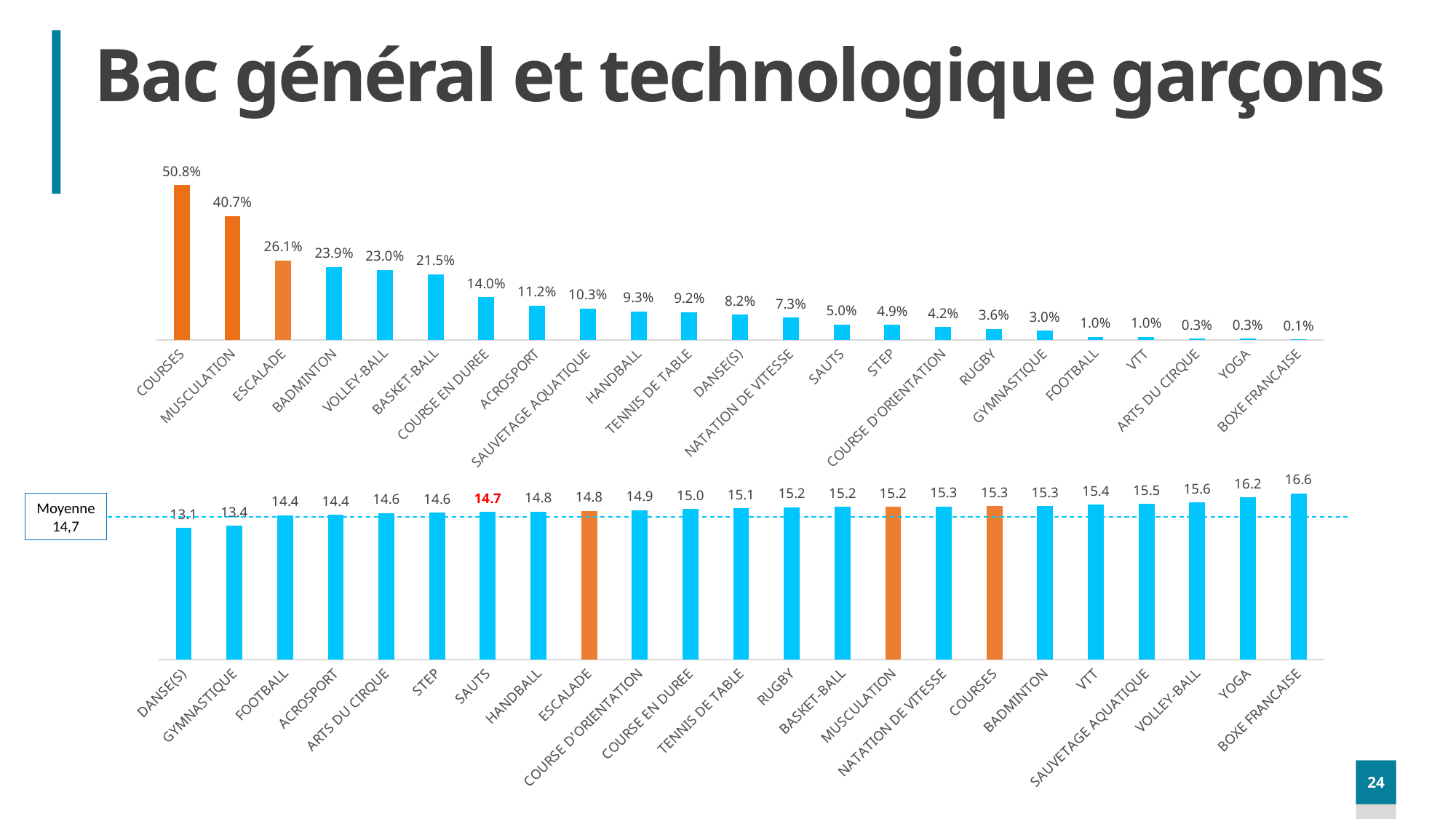
In the bottom chart, do the values rise or fall from left to right? rise In the bottom chart, which category has the lowest value? DANSE(S) In the top chart, what is the value for COURSES? 50.8% What type of chart is the bottom chart? bar chart In the bottom chart, what value is shown in the 'Moyenne' box next to the dashed line? 14,7 In the top chart, what is the difference between COURSES and MUSCULATION? 10.1% In the bottom chart, what is the value for BOXE FRANCAISE? 16.6 In the bottom chart, what is the difference between YOGA and GYMNASTIQUE? 2.8 In the top chart, how many categories are shown? 23 In the top chart, what is the value for BADMINTON? 23.9% In the top chart, which is larger, HANDBALL or DANSE(S)? HANDBALL In the top chart, which category has the lowest value? BOXE FRANCAISE